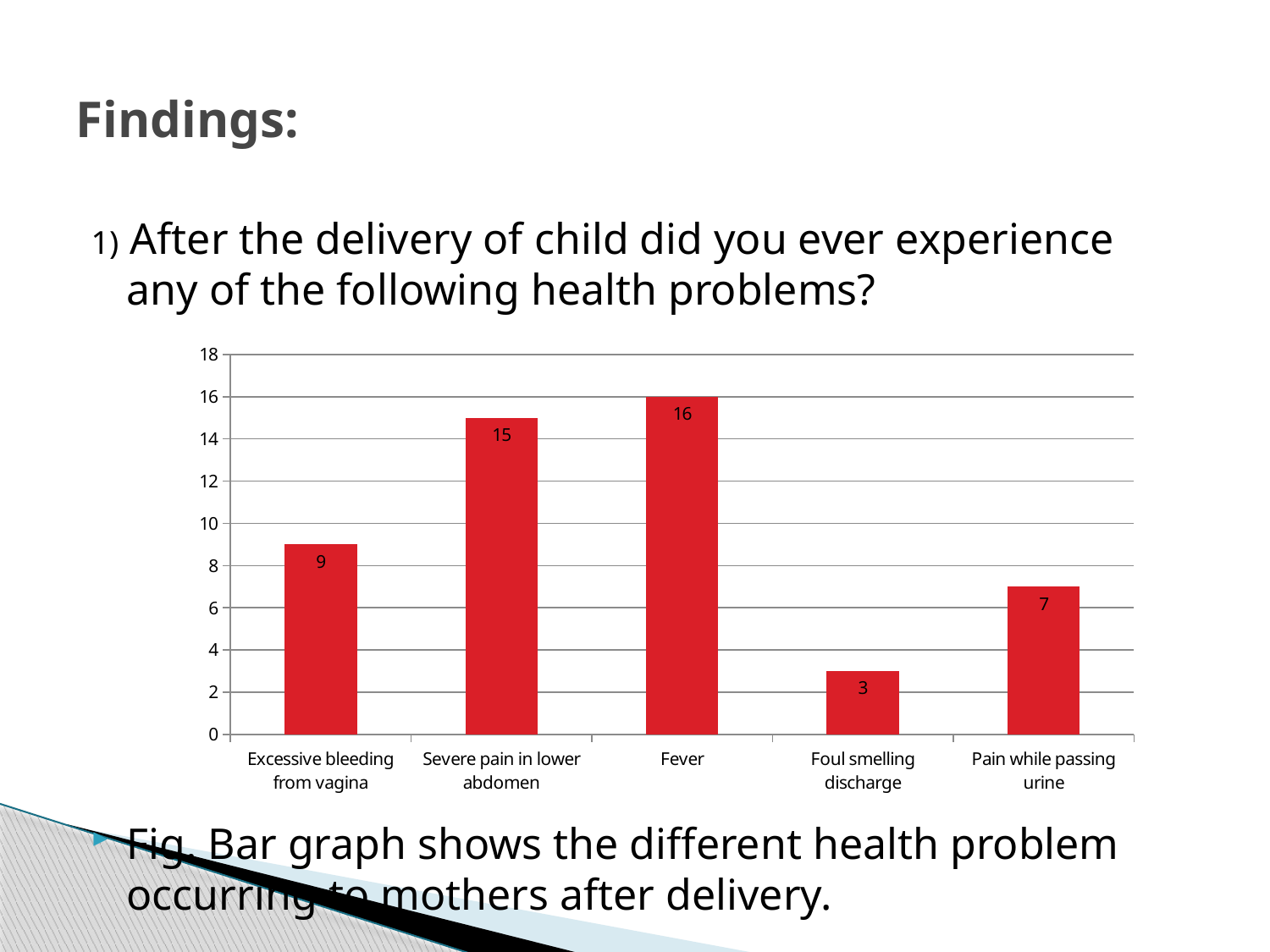
Which is larger, the value for Excessive bleeding from vagina or the value for Pain while passing urine? Excessive bleeding from vagina Which health problem has the highest value? Fever How many health problem categories are shown on the chart? 5 Which health problem has the lowest value? Foul smelling discharge What is the value for Excessive bleeding from vagina? 9 What is the value for Foul smelling discharge? 3 What is the value for Pain while passing urine? 7 What is the difference between the values for Fever and Severe pain in lower abdomen? 1 What is the difference between the values for Excessive bleeding from vagina and Foul smelling discharge? 6 Is the value for Severe pain in lower abdomen greater or less than 10? greater What is the value for Fever? 16 What kind of chart is shown on the slide? Bar chart